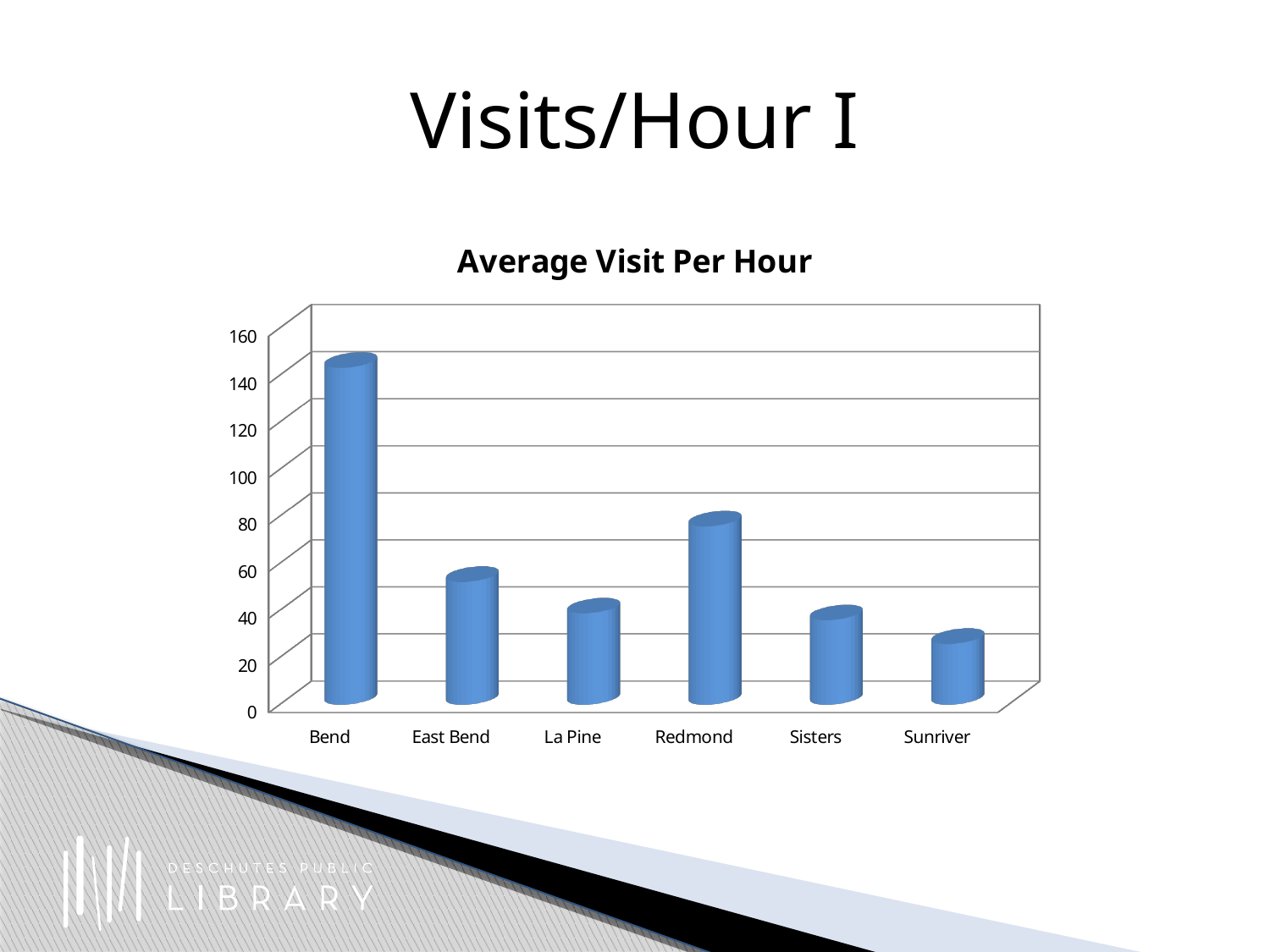
Which branch has the lowest average visits per hour? Sunriver How many library branches are shown on the x axis of the chart? 6 Which has a higher average visits per hour, Redmond or East Bend? Redmond What kind of chart is shown on the slide? bar chart Which has a higher average visits per hour, Sisters or Bend? Bend Is the value for Sunriver greater or less than 40? less What is the title of the chart? Average Visit Per Hour Is the value for East Bend greater or less than 40? greater Is the value for Bend greater or less than 120? greater Which branch has the highest average visits per hour? Bend